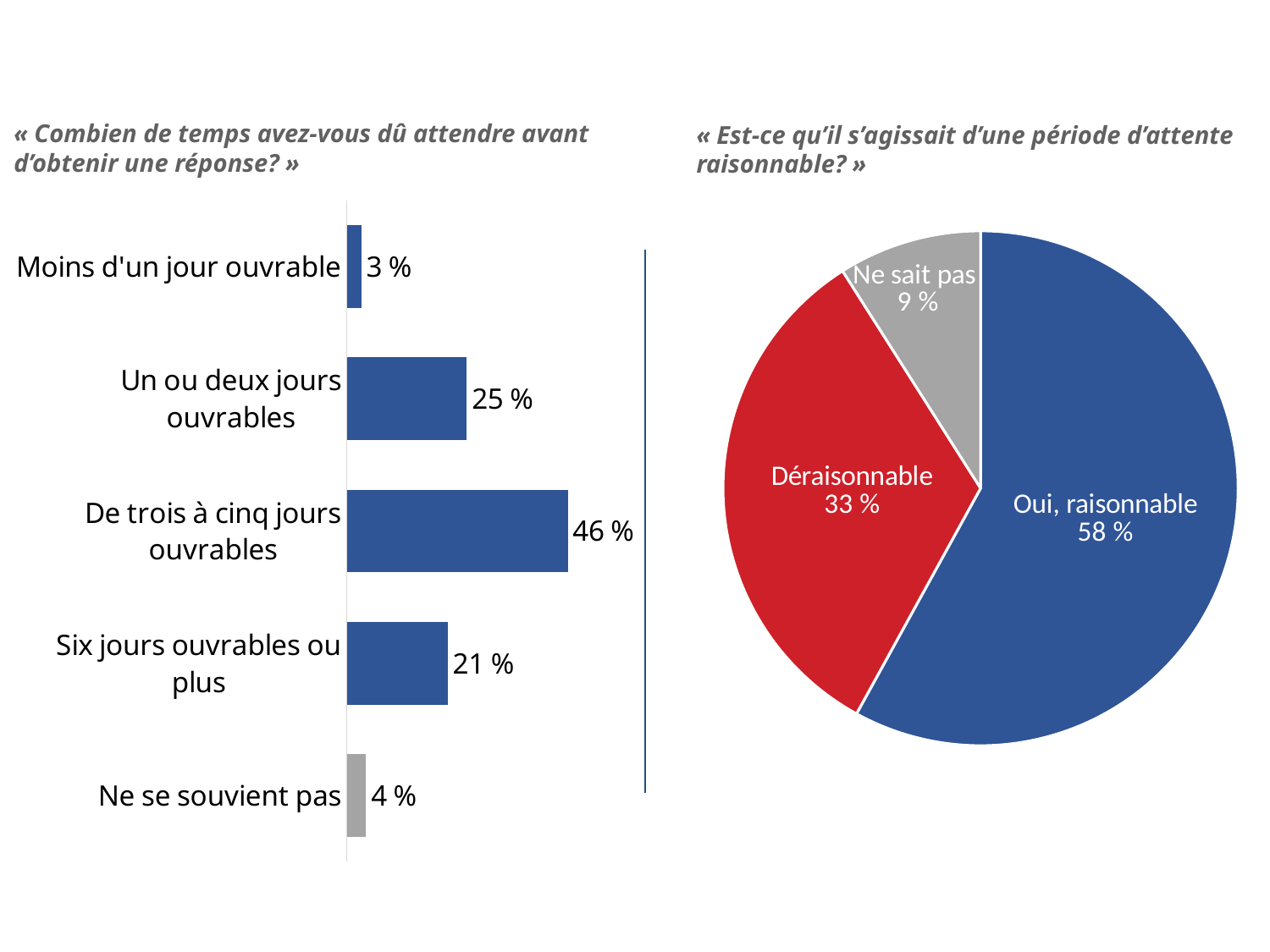
In the left chart, which is larger: "Un ou deux jours ouvrables" or "Six jours ouvrables ou plus"? Un ou deux jours ouvrables In the left chart (« Combien de temps avez-vous dû attendre avant d'obtenir une réponse? »), what is the value for "De trois à cinq jours ouvrables"? 46 % In the right chart (« Est-ce qu'il s'agissait d'une période d'attente raisonnable? »), what share is "Déraisonnable"? 33 % In the right chart, which slice is the largest? Oui, raisonnable What kind of chart is the chart on the right? Pie chart In the left chart, which category has the lowest value? Moins d'un jour ouvrable In the left chart, what is the value for "Un ou deux jours ouvrables"? 25 % What kind of chart is the chart on the left? Bar chart In the right chart, what colour is the "Ne sait pas" slice? Grey In the left chart, what is the difference between "De trois à cinq jours ouvrables" and "Six jours ouvrables ou plus"? 25 % How many categories does the left bar chart show? 5 In the left chart, which category has the highest value? De trois à cinq jours ouvrables